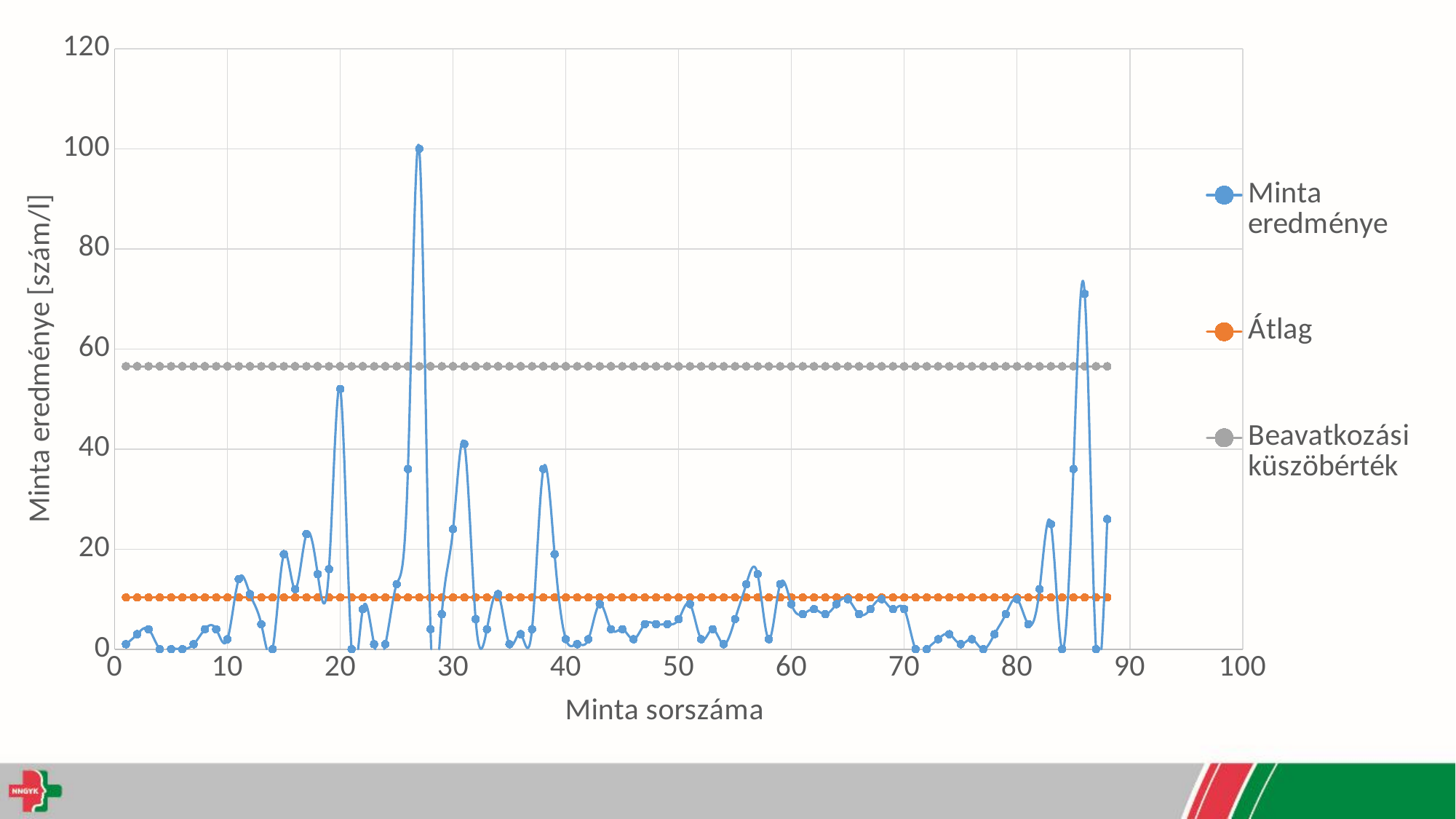
Which is larger, the Minta eredménye value at sample 27 or at sample 86? sample 27 What kind of chart is shown on the slide? line chart How many series does the legend list? 3 Is the highest Minta eredménye value greater or less than 80? greater Is the Átlag line greater or less than 20? less Which is higher, the Átlag line or the Beavatkozási küszöbérték line? Beavatkozási küszöbérték What is the title of the x axis? Minta sorszáma Is the Beavatkozási küszöbérték line greater or less than 40? greater What is the title of the y axis? Minta eredménye [szám/l] Which series is drawn in orange? Átlag